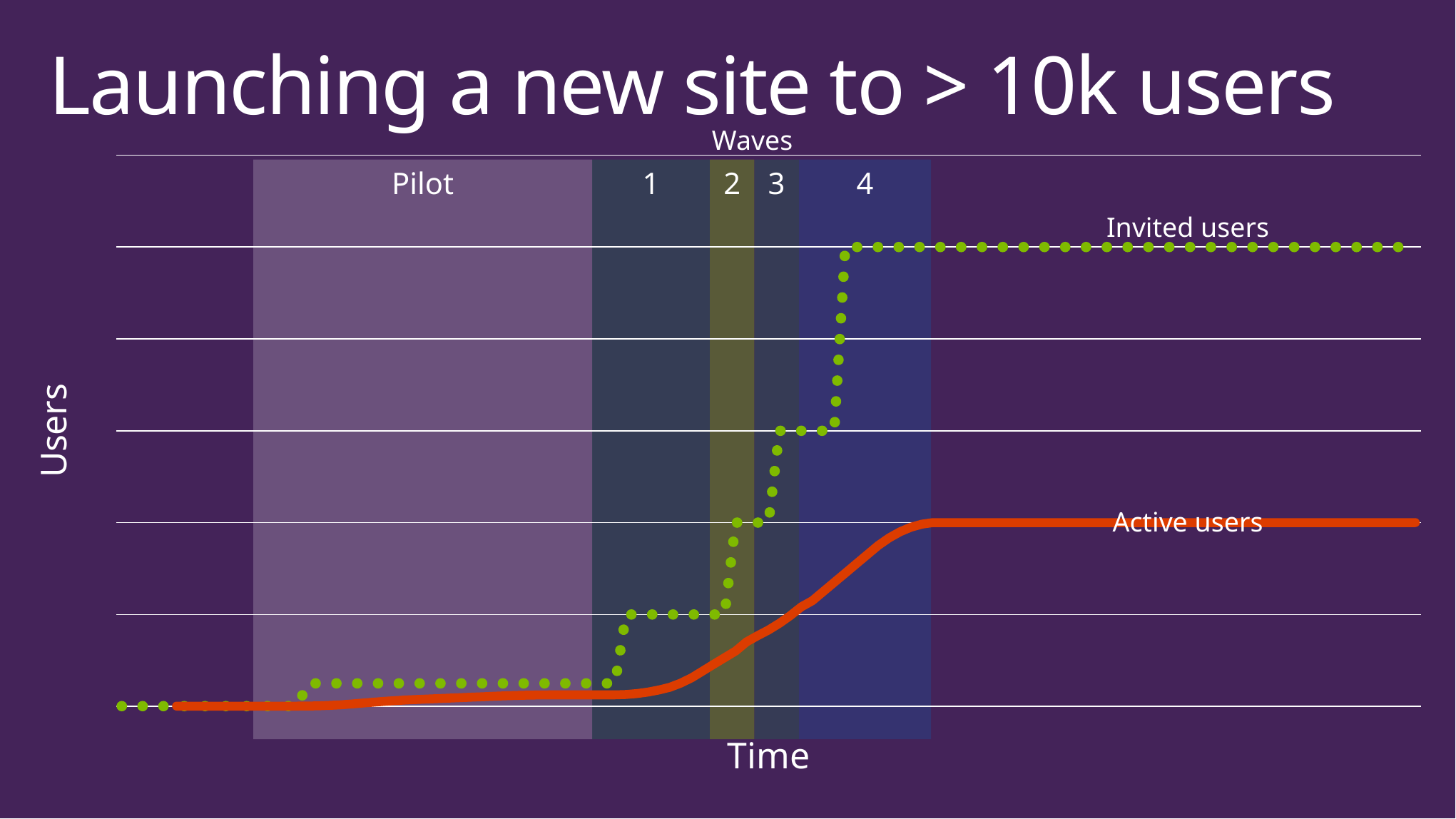
How many data series are plotted on the chart? 2 What are the names of the two series plotted on the chart? Invited users and Active users What is the label of the horizontal axis? Time Which phase comes first along the time axis, Pilot or wave 1? Pilot Do the Invited users values rise or fall over time? rise Which series ends higher at the right side of the chart, Invited users or Active users? Invited users Do the Active users values rise or fall over time? rise How many numbered waves are shown after the Pilot phase? 4 What kind of chart is shown on the slide? line chart